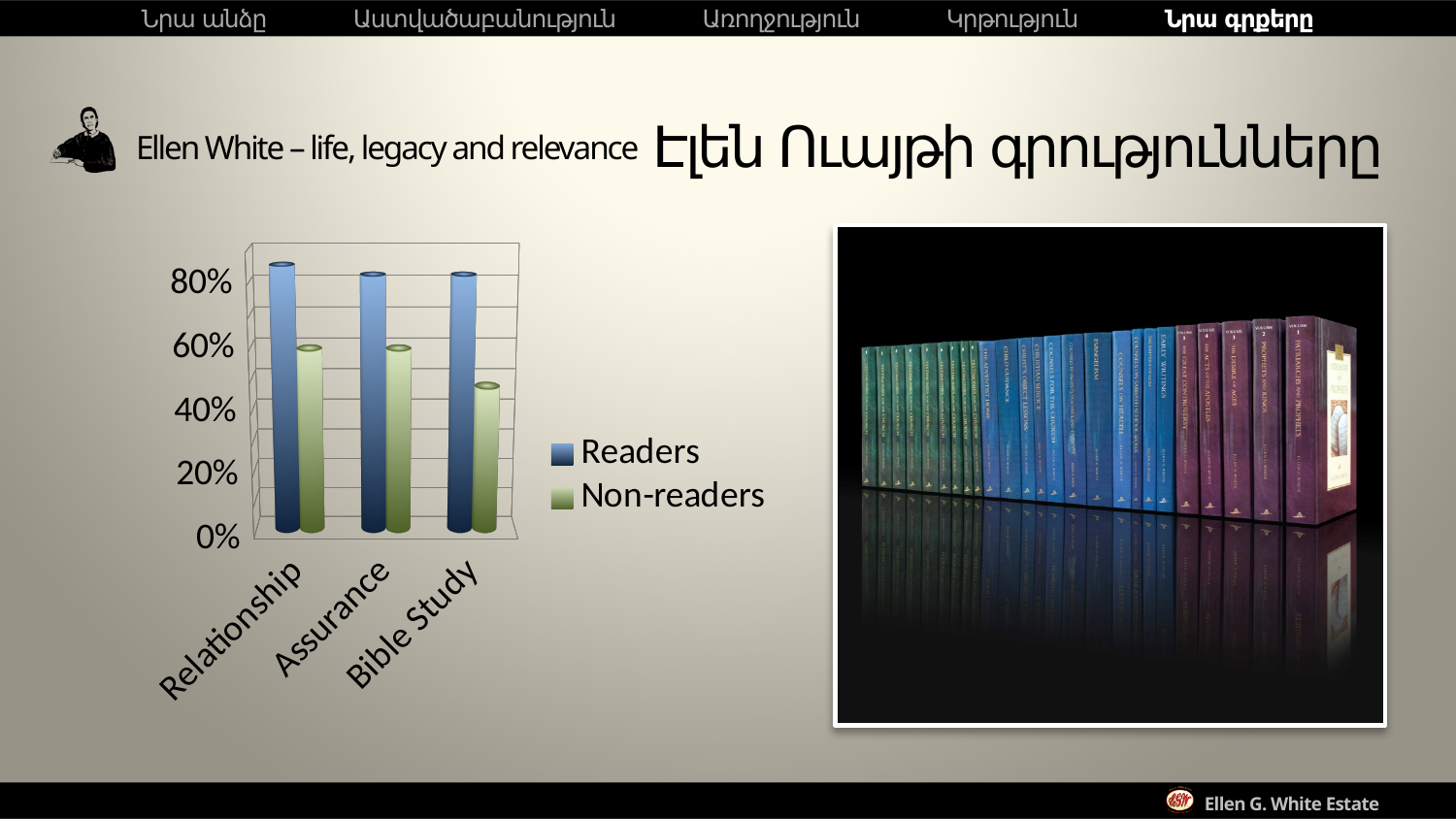
Is the Readers value for Assurance greater or less than 60%? greater For Relationship, which is larger: Readers or Non-readers? Readers For Bible Study, which is larger: Readers or Non-readers? Readers Which colour represents the Non-readers series in the chart? green Is the Readers value for Relationship greater or less than 80%? greater Is the Non-readers value for Bible Study greater or less than 40%? greater What are the two series named in the chart's legend? Readers and Non-readers What kind of chart is shown on the slide? bar chart How many series does the chart's legend list? 2 How many categories are shown on the x axis of the chart? 3 Among the Non-readers bars, which category is lowest? Bible Study